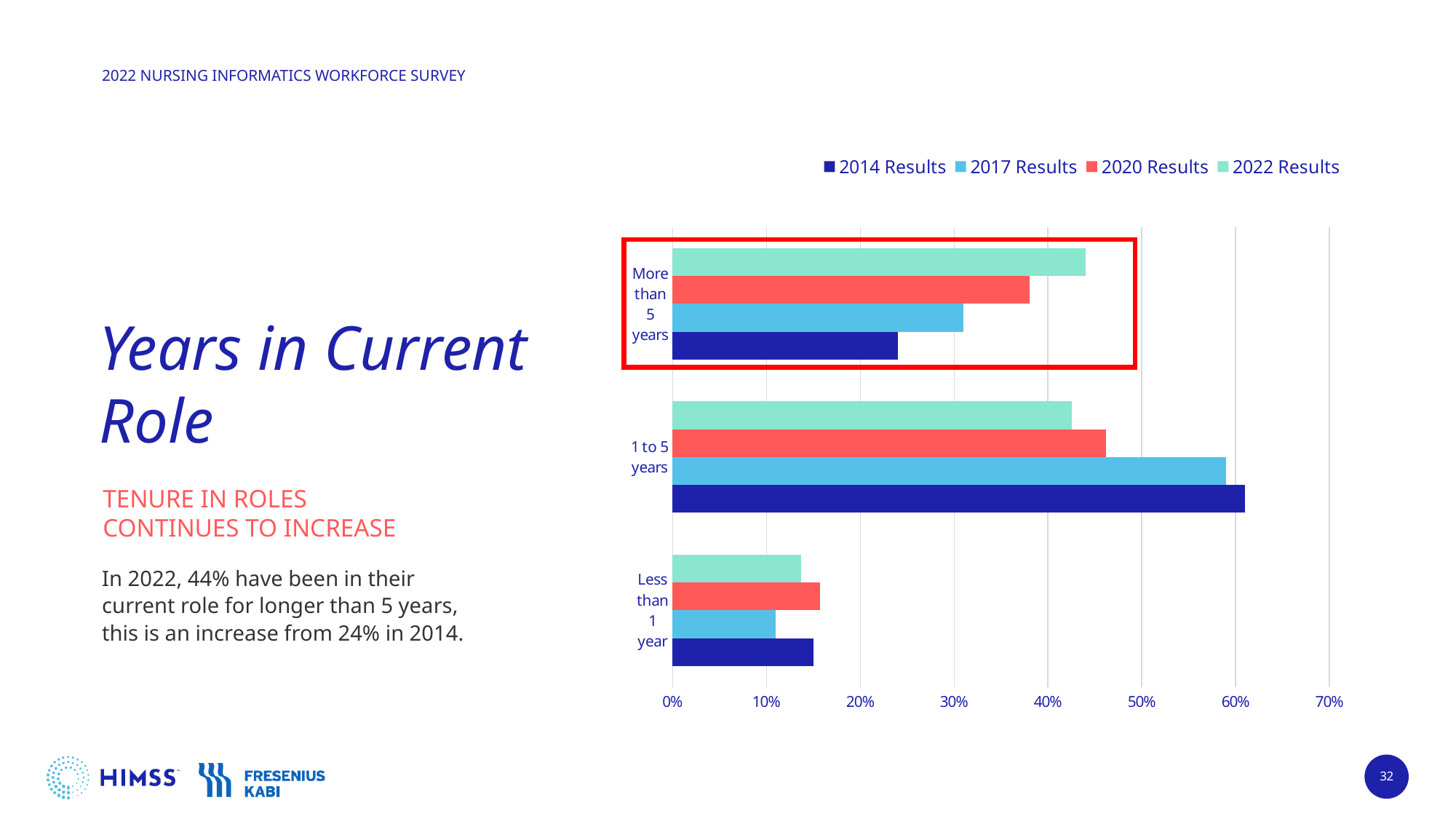
Is the 2020 Results value for 'More than 5 years' greater or less than 40%? less What is the 2022 Results value for 'More than 5 years'? 44% By how many percentage points did the 'More than 5 years' share increase from 2014 to 2022? 20 percentage points What kind of chart is shown on the slide? bar chart For '1 to 5 years', which is larger: the 2017 Results value or the 2020 Results value? 2017 Results Which series has the lowest value for 'Less than 1 year'? 2017 Results For 'More than 5 years', do the values rise or fall from 2014 Results to 2022 Results? rise How many categories are shown on the chart? 3 How many series does the legend list? 4 Which series has the highest value for 'More than 5 years'? 2022 Results Is the 2014 Results value for '1 to 5 years' greater or less than 50%? greater What is the 2014 Results value for 'More than 5 years'? 24%